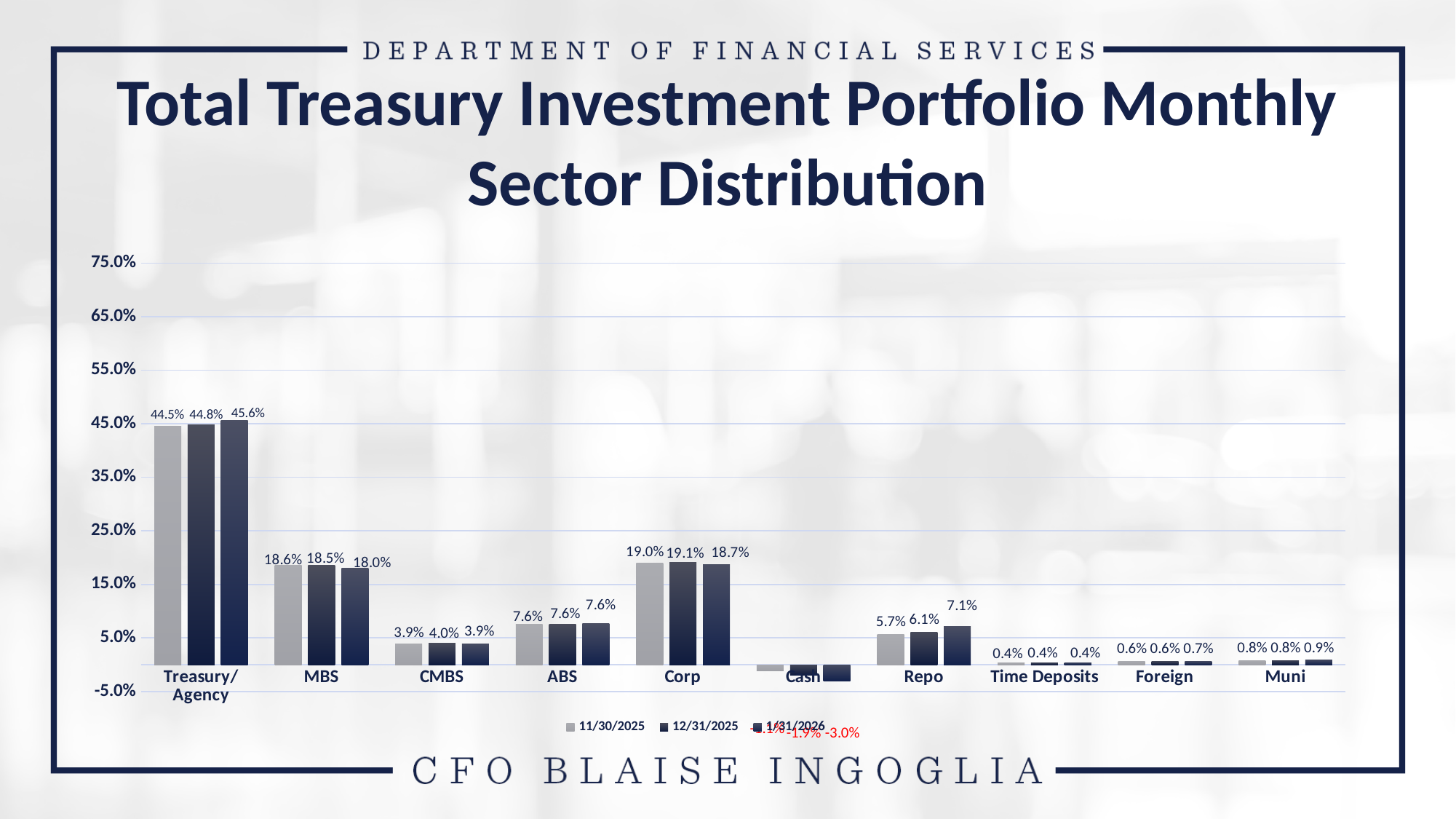
What is the value for Treasury/Agency in the 1/31/2026 series? 45.6% Is the value for Corp in the 1/31/2026 series greater or less than 15.0%? greater How many sectors are shown on the x axis? 10 What is the title of the chart? Total Treasury Investment Portfolio Monthly Sector Distribution How many series does the legend list? 3 What is the value for Repo in the 12/31/2025 series? 6.1% Which is larger for MBS: the 11/30/2025 value or the 1/31/2026 value? 11/30/2025 What kind of chart is shown on the slide? Bar chart Which sector has the lowest value in the 1/31/2026 series? Cash What is the value for Corp in the 11/30/2025 series? 19.0% Which sector has the highest value in the 12/31/2025 series? Treasury/Agency What is the difference between the 1/31/2026 and 11/30/2025 values for Repo? 1.4%